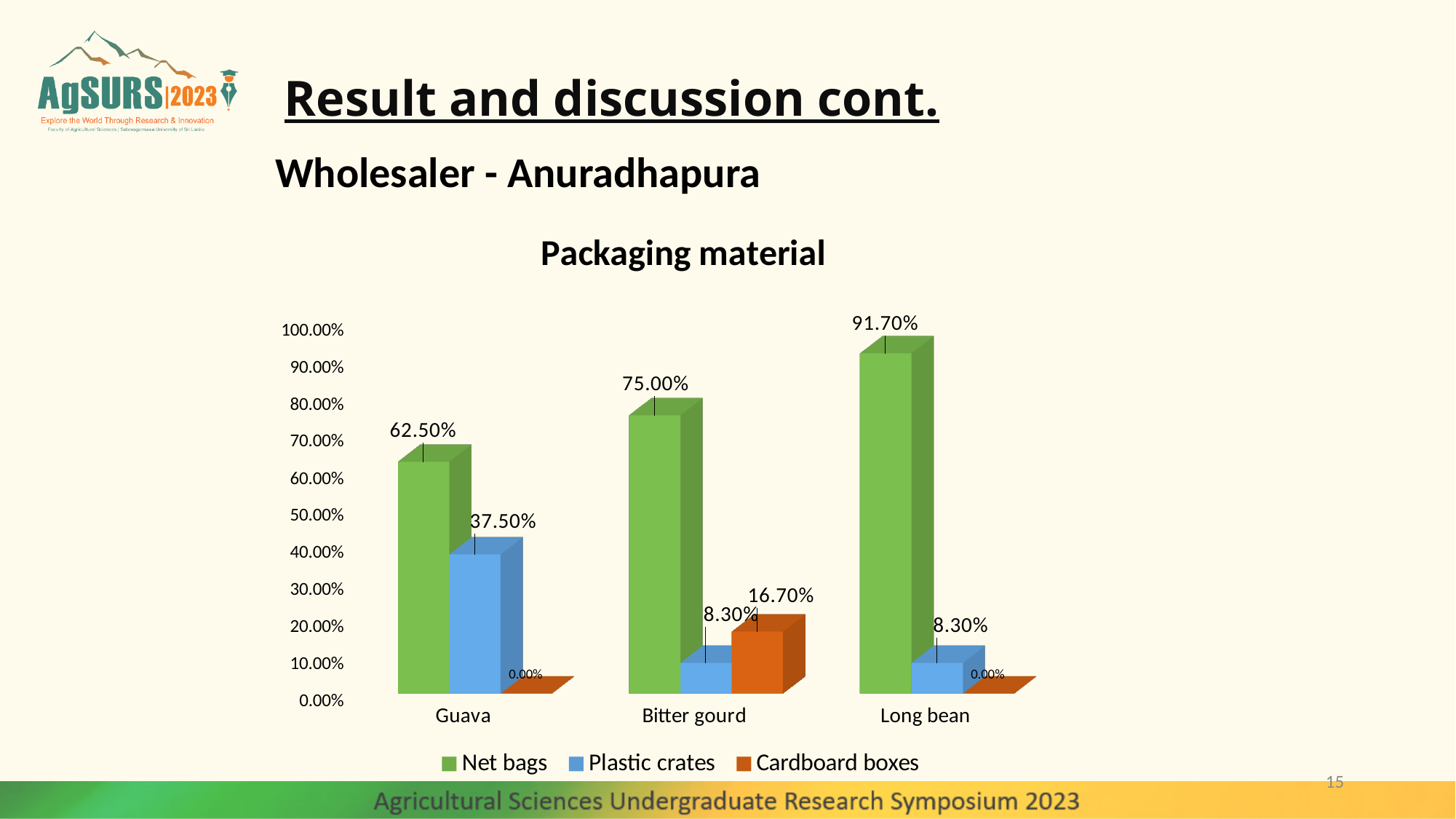
What is the value for Net bags for Guava? 62.50% Which is larger for Guava: Net bags or Plastic crates? Net bags Which category has the lowest value for Net bags? Guava What is the value for Plastic crates for Guava? 37.50% What is the title of the chart? Packaging material What kind of chart is shown? Bar chart What is the value for Cardboard boxes for Bitter gourd? 16.70% What is the difference between the Net bags values for Long bean and Bitter gourd? 16.70% What is the value for Net bags for Long bean? 91.70% Which category has the highest value for Net bags? Long bean How many series does the legend list? 3 How many categories are shown on the x axis? 3